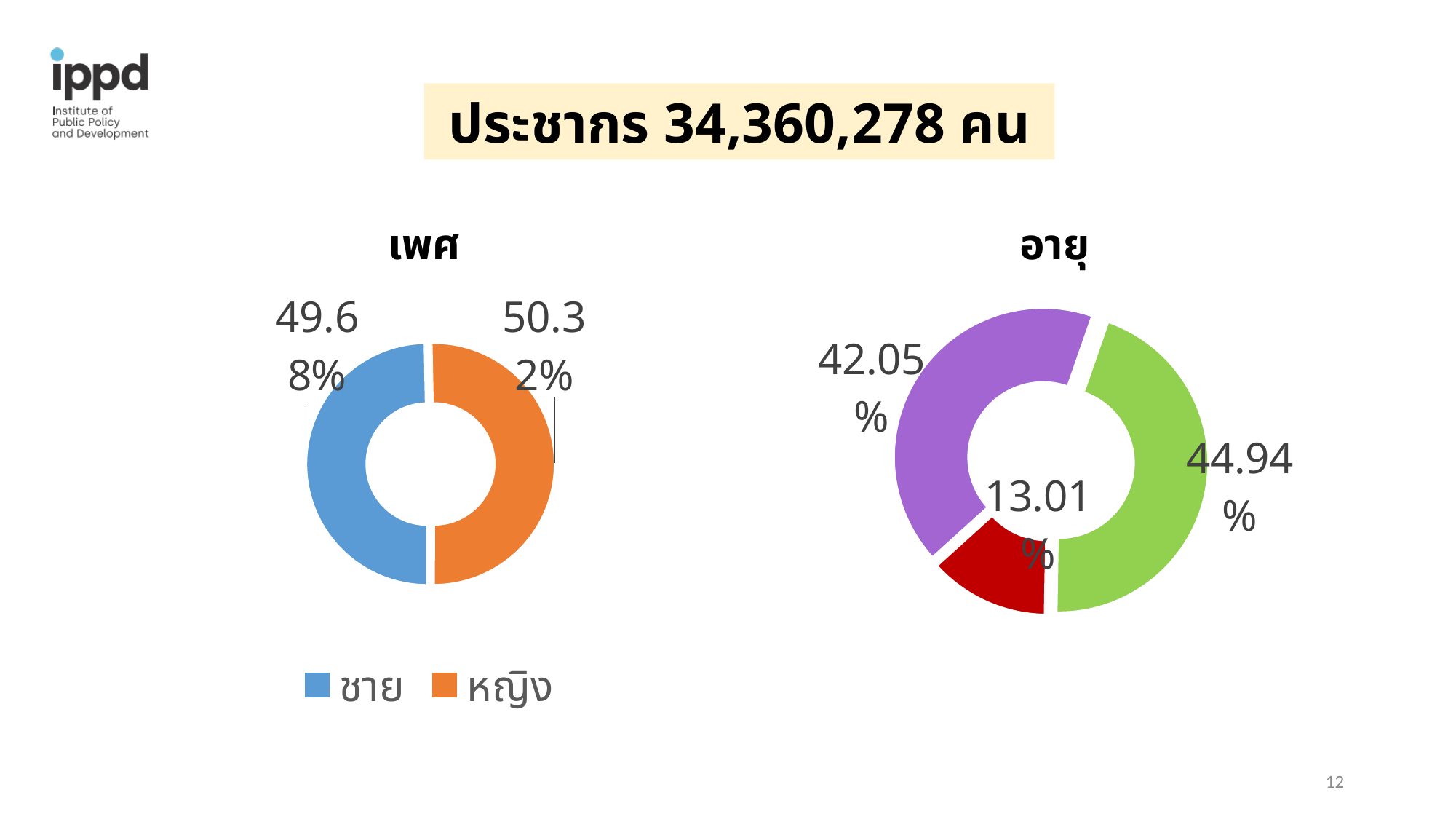
How many entries does the legend of the chart titled เพศ list? 2 In the chart titled อายุ, what is the difference between the green slice and the purple slice? 2.89% In the chart titled เพศ, what is the difference between the values for หญิง and ชาย? 0.64% What kind of chart is the chart titled เพศ? doughnut chart In the chart titled อายุ, what is the value of the smallest slice? 13.01% What colour is the slice for ชาย in the chart titled เพศ? blue How many slices does the chart titled อายุ have? 3 In the chart titled เพศ, what is the value for หญิง? 50.32% In the chart titled อายุ, what is the value of the largest slice? 44.94% In the chart titled เพศ, which is larger, ชาย or หญิง? หญิง In the chart titled เพศ, what is the value for ชาย? 49.68% In the chart titled อายุ, what is the value of the purple slice? 42.05%